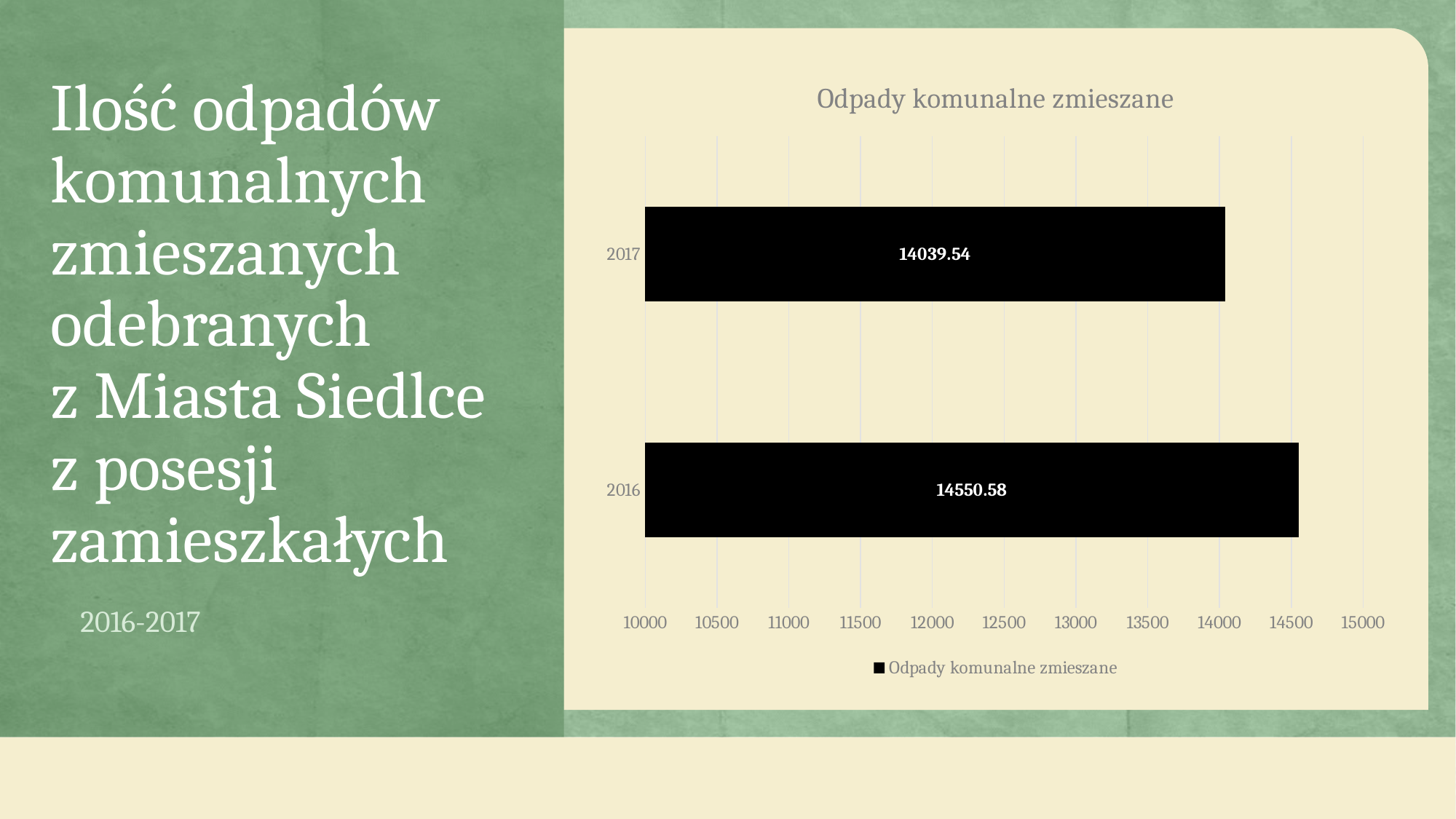
Is the value for 2016 greater or less than 14000? greater What kind of chart is shown? bar chart Which is larger, the value for 2016 or the value for 2017? 2016 How many series does the legend list? 1 What is the value for 2016? 14550.58 Which year has the highest value? 2016 What is the difference between the values for 2016 and 2017? 511.04 What is the value for 2017? 14039.54 What is the title of the chart? Odpady komunalne zmieszane Is the value for 2017 greater or less than 14500? less Which year has the lowest value? 2017 How many years are shown in the chart? 2